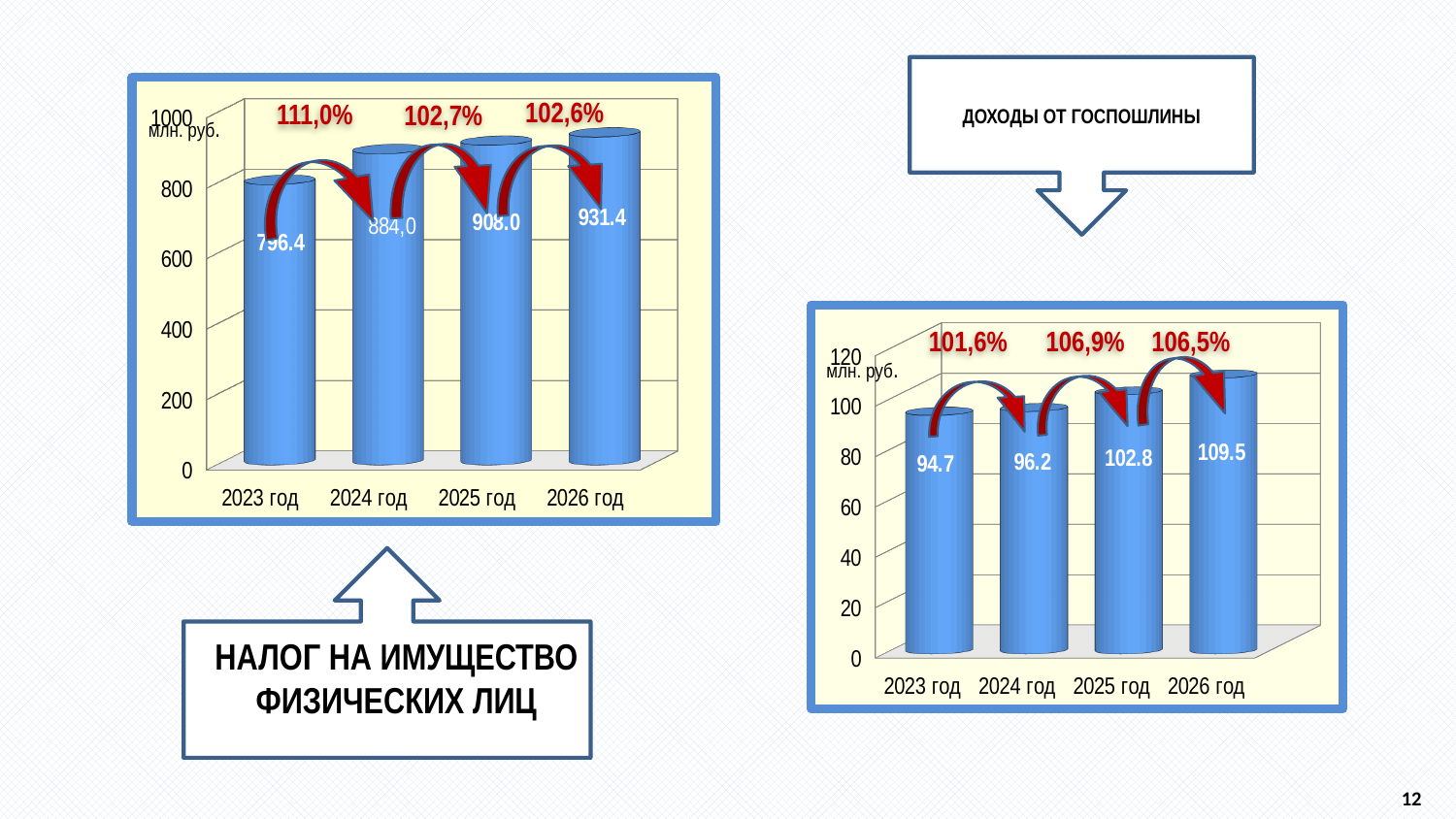
On the chart for ДОХОДЫ ОТ ГОСПОШЛИНЫ (right), what is the value for 2023 год? 94.7 On the chart for НАЛОГ НА ИМУЩЕСТВО ФИЗИЧЕСКИХ ЛИЦ (left), what is the difference between the values for 2026 год and 2025 год? 23.4 On the chart for НАЛОГ НА ИМУЩЕСТВО ФИЗИЧЕСКИХ ЛИЦ (left), what is the value for 2026 год? 931.4 On the chart for НАЛОГ НА ИМУЩЕСТВО ФИЗИЧЕСКИХ ЛИЦ (left), what is the value for 2024 год? 884,0 On the chart for ДОХОДЫ ОТ ГОСПОШЛИНЫ (right), do the values rise or fall from 2023 год to 2026 год? Rise On the chart for ДОХОДЫ ОТ ГОСПОШЛИНЫ (right), what is the difference between the values for 2026 год and 2025 год? 6.7 On the chart for ДОХОДЫ ОТ ГОСПОШЛИНЫ (right), what is the value for 2026 год? 109.5 On the chart for НАЛОГ НА ИМУЩЕСТВО ФИЗИЧЕСКИХ ЛИЦ (left), which year has the highest value? 2026 год On the chart for ДОХОДЫ ОТ ГОСПОШЛИНЫ (right), which year has the highest value? 2026 год What kind of chart is the one for НАЛОГ НА ИМУЩЕСТВО ФИЗИЧЕСКИХ ЛИЦ (left)? Bar chart On the chart for ДОХОДЫ ОТ ГОСПОШЛИНЫ (right), how many years are shown on the x axis? 4 On the chart for ДОХОДЫ ОТ ГОСПОШЛИНЫ (right), which year has the lowest value? 2023 год